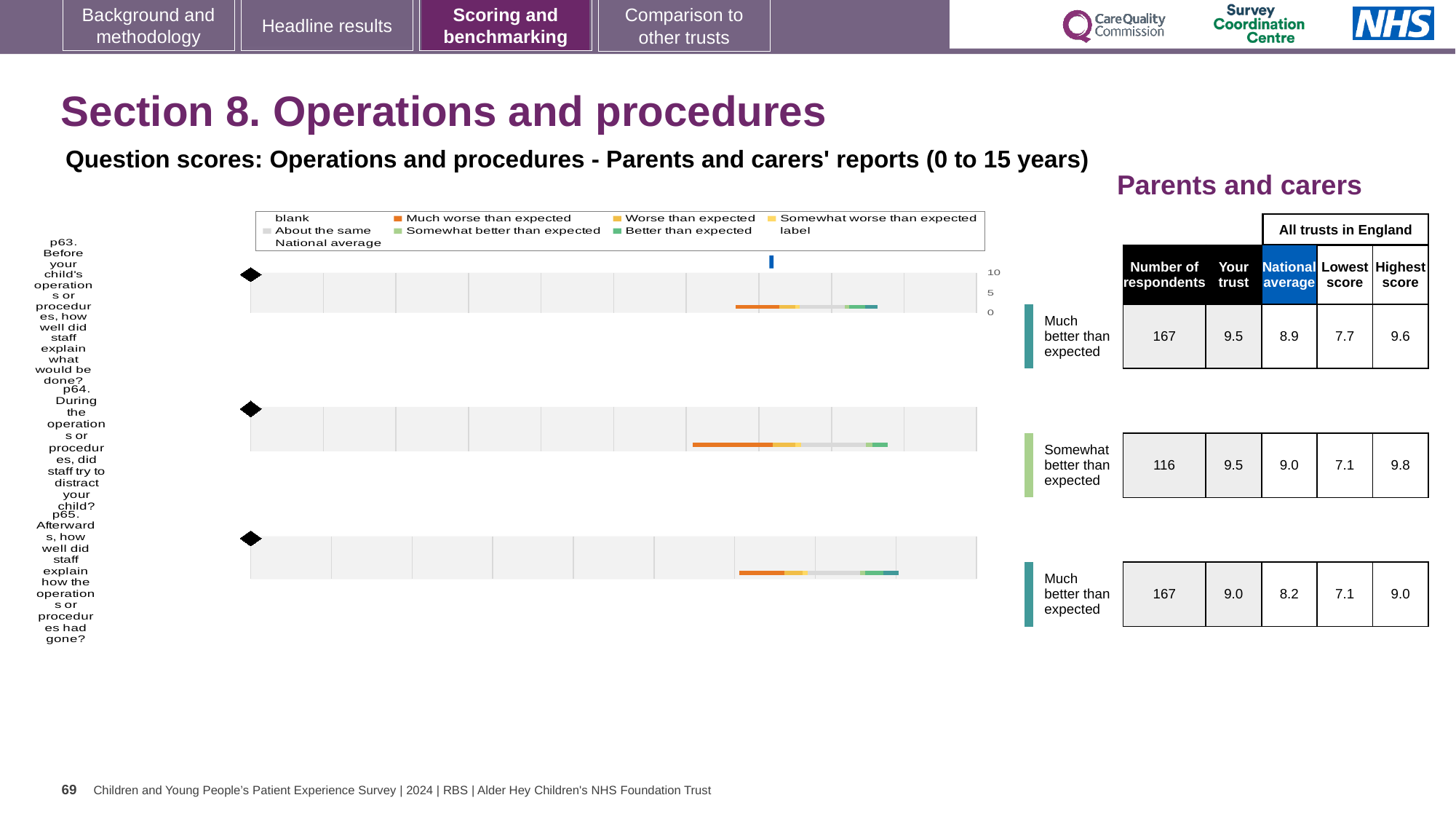
What is the difference between the highest score and the lowest score for question p64? 2.7 How many questions are plotted on this slide? 3 By how much does the 'Your trust' score for p65 exceed the national average for p65? 0.8 Which of the three questions (p63, p64, p65) has the lowest 'Your trust' score? p65 What is the national average score for question p65 (Afterwards, how well did staff explain how the operations or procedures had gone?)? 8.2 What is the 'Your trust' score for question p64 (During the operations or procedures, did staff try to distract your child?)? 9.5 What is the lowest score among all trusts in England for question p63? 7.7 Which of the three questions (p63, p64, p65) has the fewest respondents? p64 How many respondents are shown for question p63 (Before your child's operations or procedures, how well did staff explain what would be done?)? 167 Which has more respondents, question p63 or question p64? p63 What benchmark category is shown for question p64? Somewhat better than expected What is the highest score among all trusts in England for question p64? 9.8